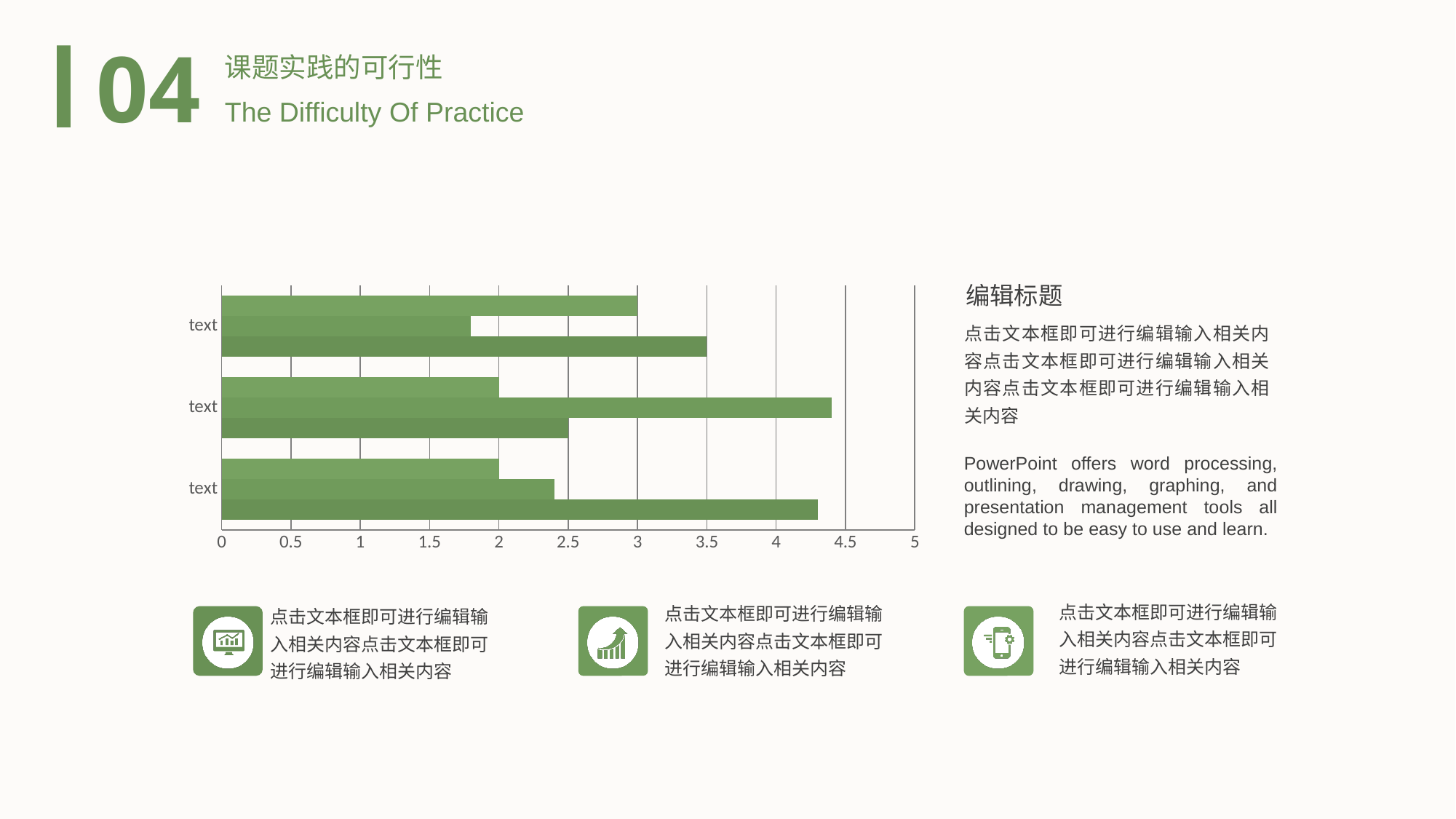
What is the maximum value shown on the horizontal axis of the chart? 5 Is the value of the bottom bar in the bottommost category group greater or less than 4? greater What is the value of the top (first) bar in the middle category group? 2 What kind of chart is shown on the slide? bar chart Is the value of the middle bar in the topmost category group greater or less than 2? less How many bars are drawn for each category in the chart? 3 In the middle category group, which bar is the longest: the top, middle, or bottom bar? middle bar In the topmost category group, which bar is the shortest: the top, middle, or bottom bar? middle bar Is the value of the middle bar in the middle category group greater or less than 4? greater How many categories are shown on the vertical axis of the chart? 3 What is the value of the top (first) bar in the topmost category group? 3 In the topmost category group, which is larger: the top bar or the bottom bar? bottom bar